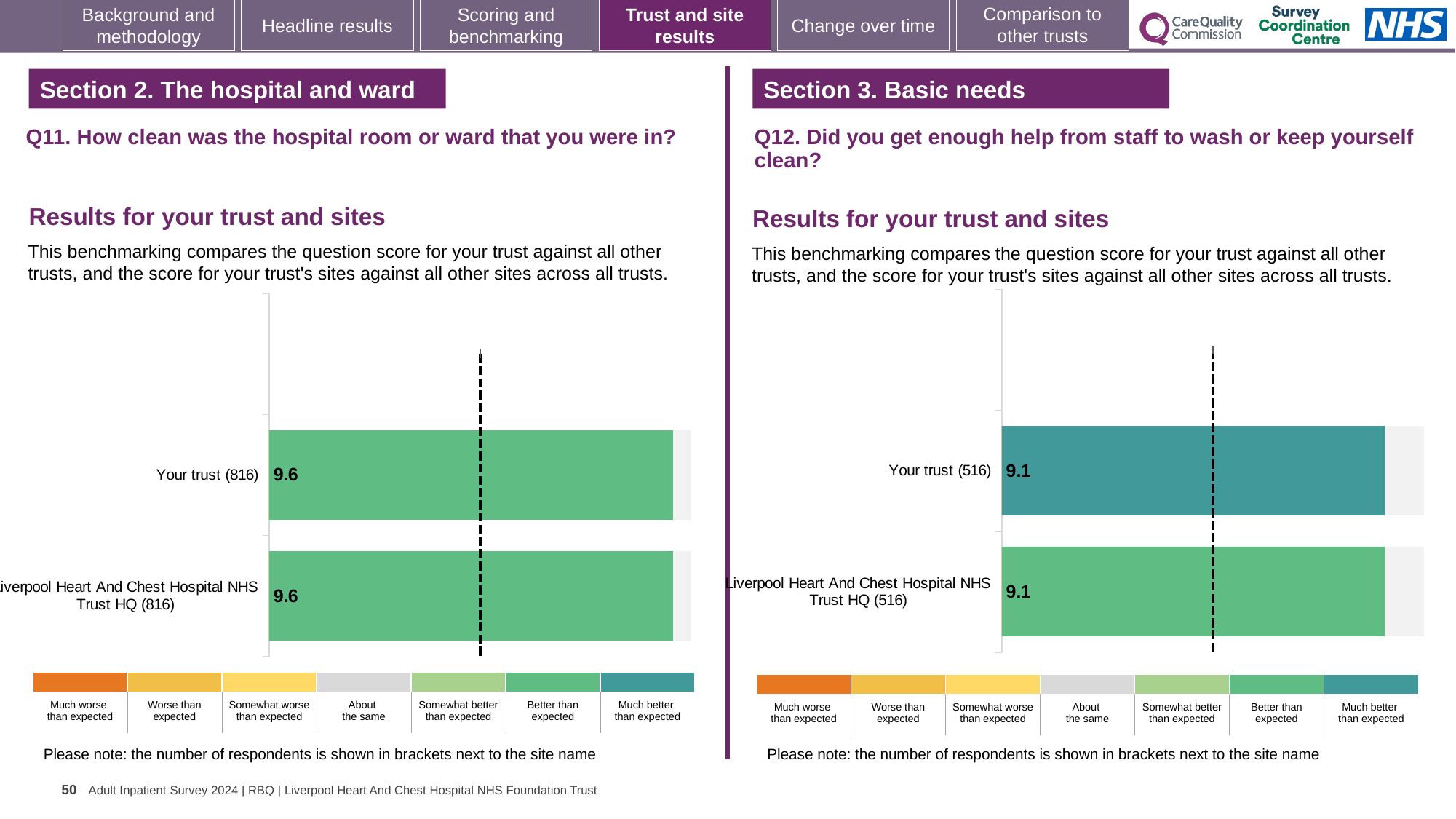
What type of chart is used for the Q11 results on the left? Bar chart On the Q11 chart (left), what is the score for Liverpool Heart And Chest Hospital NHS Trust HQ (816)? 9.6 On the Q12 chart (right), what is the score for Your trust (516)? 9.1 On the Q12 chart (right), which benchmark category does the colour of the Your trust (516) bar correspond to in the legend? Much better than expected On the Q11 chart (left), which benchmark category does the colour of the Your trust (816) bar correspond to in the legend? Better than expected On the Q12 chart (right), what is the difference between the score for Your trust and the score for Liverpool Heart And Chest Hospital NHS Trust HQ? 0.0 On the Q12 chart (right), what is the score for Liverpool Heart And Chest Hospital NHS Trust HQ (516)? 9.1 On the Q11 chart (left), what is the difference between the score for Your trust and the score for Liverpool Heart And Chest Hospital NHS Trust HQ? 0.0 On the Q11 chart (left), what is the score for Your trust (816)? 9.6 How many respondents are shown in brackets for Your trust on the Q12 chart (right)? 516 How many bars are plotted on the Q11 chart (left)? 2 How many bars are plotted on the Q12 chart (right)? 2